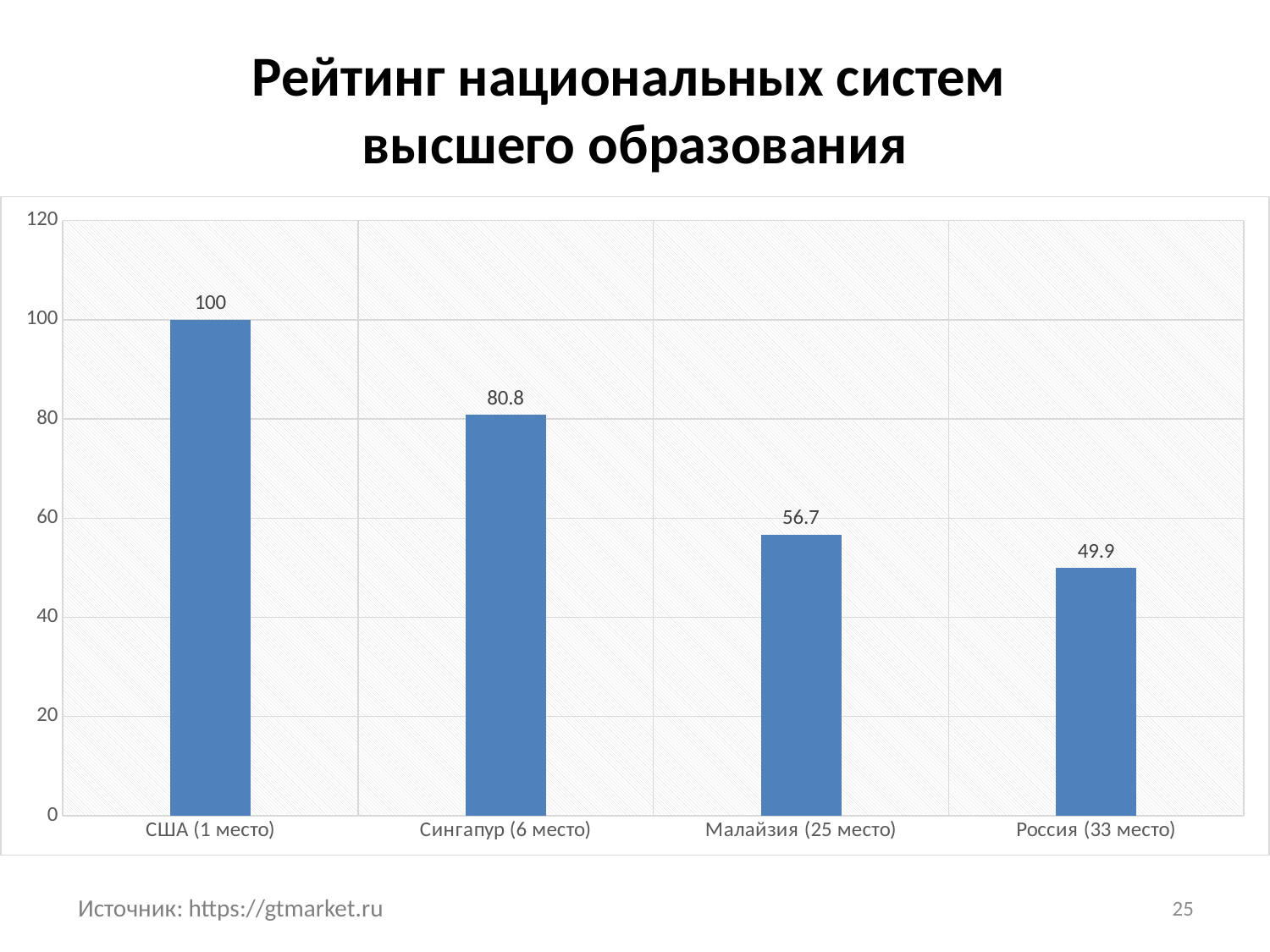
How many categories are shown on the chart? 4 What is the value for Малайзия (25 место)? 56.7 Which category has the highest value? США (1 место) What is the value for США (1 место)? 100 What is the value for Россия (33 место)? 49.9 Do the values rise or fall from left to right along the x axis? fall What is the value for Сингапур (6 место)? 80.8 Is the value for Малайзия (25 место) greater or less than 60? less Which category has the lowest value? Россия (33 место) What kind of chart is shown on the slide? bar chart Which is larger, the value for Малайзия (25 место) or the value for Россия (33 место)? Малайзия (25 место) What is the difference between the values for Сингапур (6 место) and Россия (33 место)? 30.9